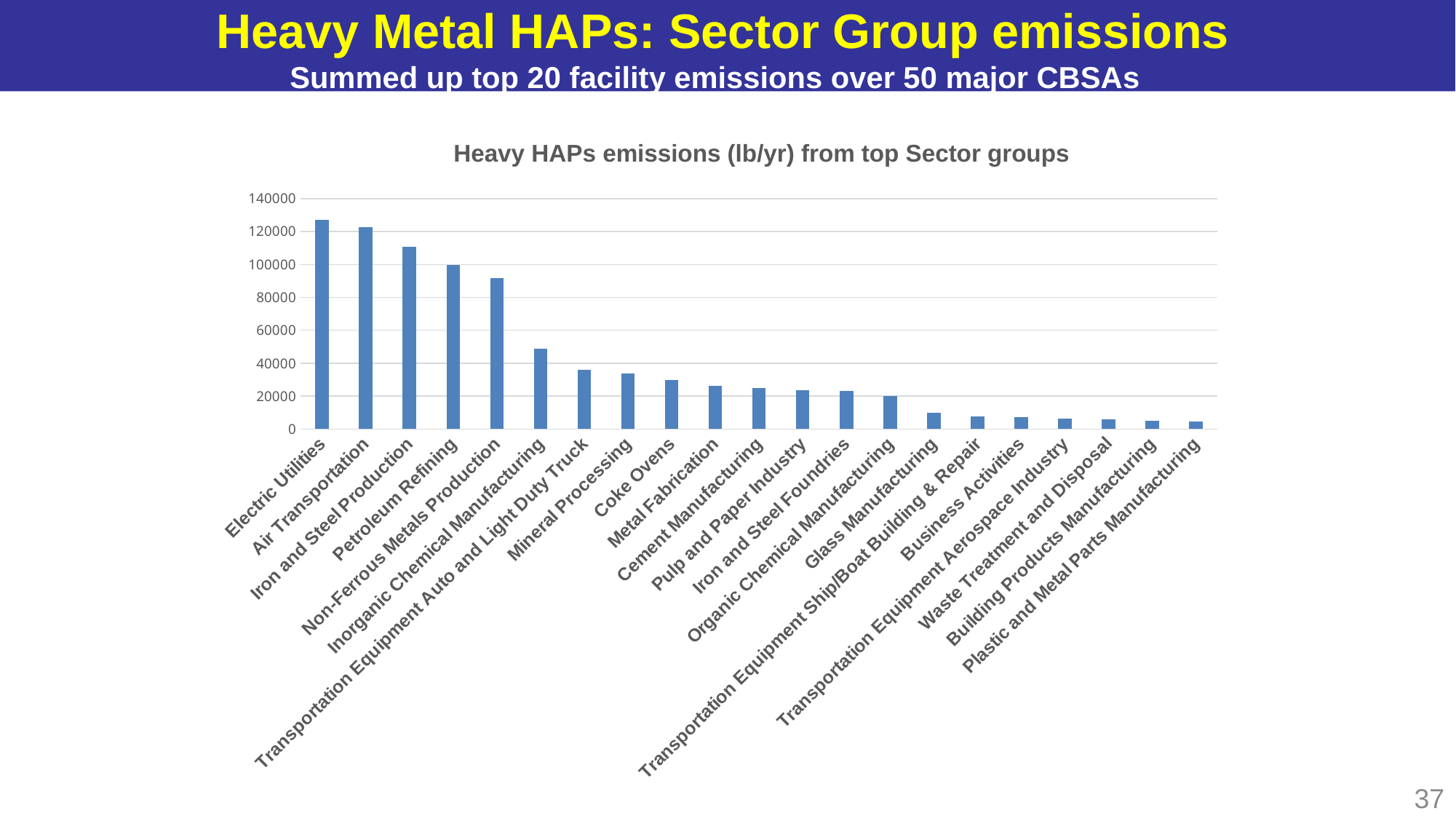
Is the value for Non-Ferrous Metals Production greater or less than 80000? greater Which sector group has the highest heavy HAPs emissions? Electric Utilities Do the values rise or fall moving from left to right along the x axis? Fall Which has higher emissions, Iron and Steel Production or Petroleum Refining? Iron and Steel Production What is the title of the chart? Heavy HAPs emissions (lb/yr) from top Sector groups Is the value for Inorganic Chemical Manufacturing greater or less than 40000? greater Which has higher emissions, Inorganic Chemical Manufacturing or Mineral Processing? Inorganic Chemical Manufacturing Is the value for Iron and Steel Production greater or less than 100000? greater What kind of chart is shown on the slide? Bar chart How many sector groups are plotted in the chart? 21